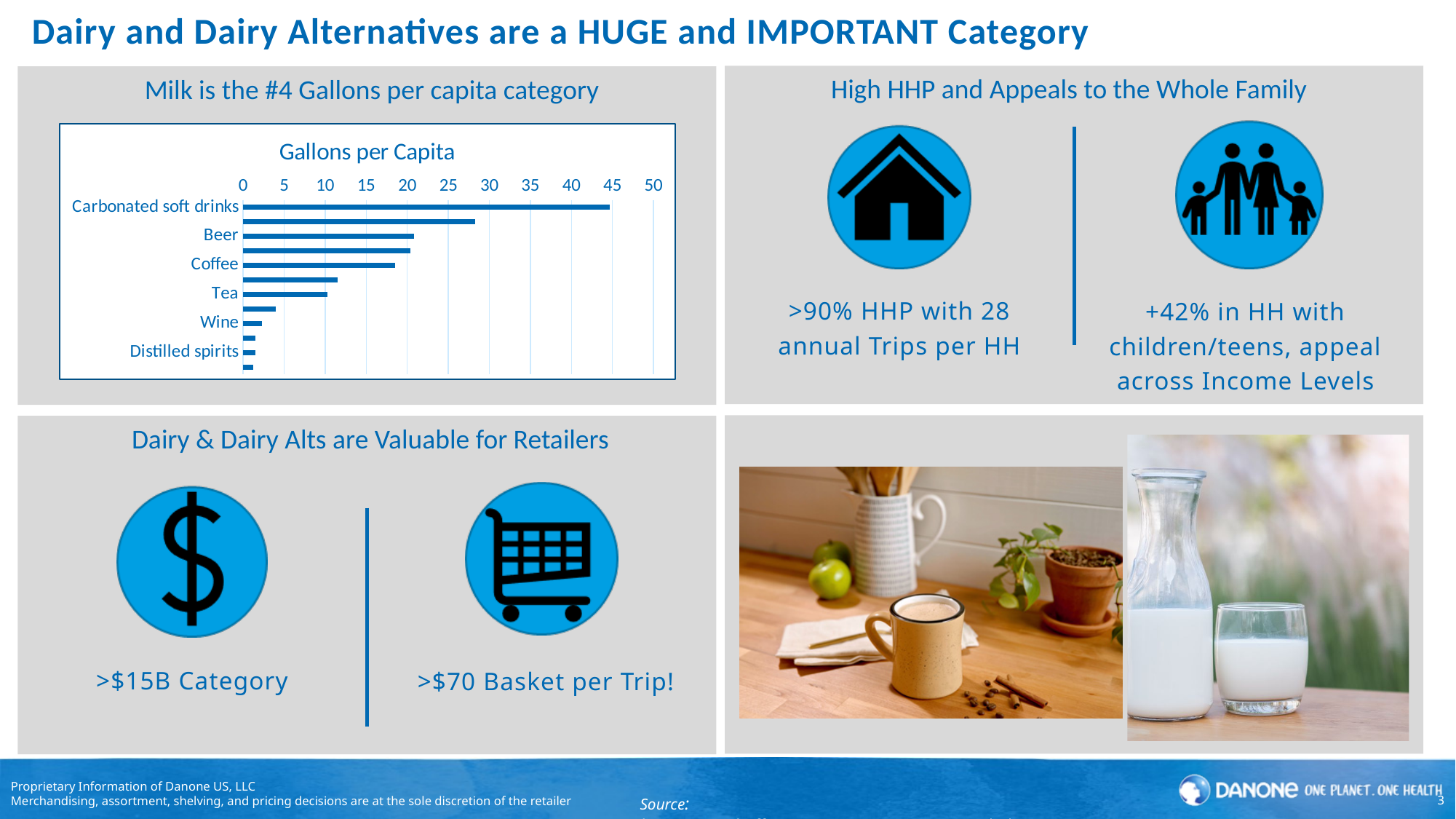
Which labeled category has the highest gallons per capita in the chart? Carbonated soft drinks Is the value for Coffee greater or less than 20? less Which has a higher gallons per capita value, Tea or Wine? Tea Is the value for Tea greater or less than 15? less How many category labels are printed on the vertical axis of the chart? 6 Is the value for Carbonated soft drinks greater or less than 40? greater What is the highest tick value shown on the horizontal axis of the chart? 50 Which has a higher gallons per capita value, Beer or Coffee? Beer What kind of chart is shown under the heading 'Milk is the #4 Gallons per capita category'? bar chart What is the title of the chart on the slide? Gallons per Capita